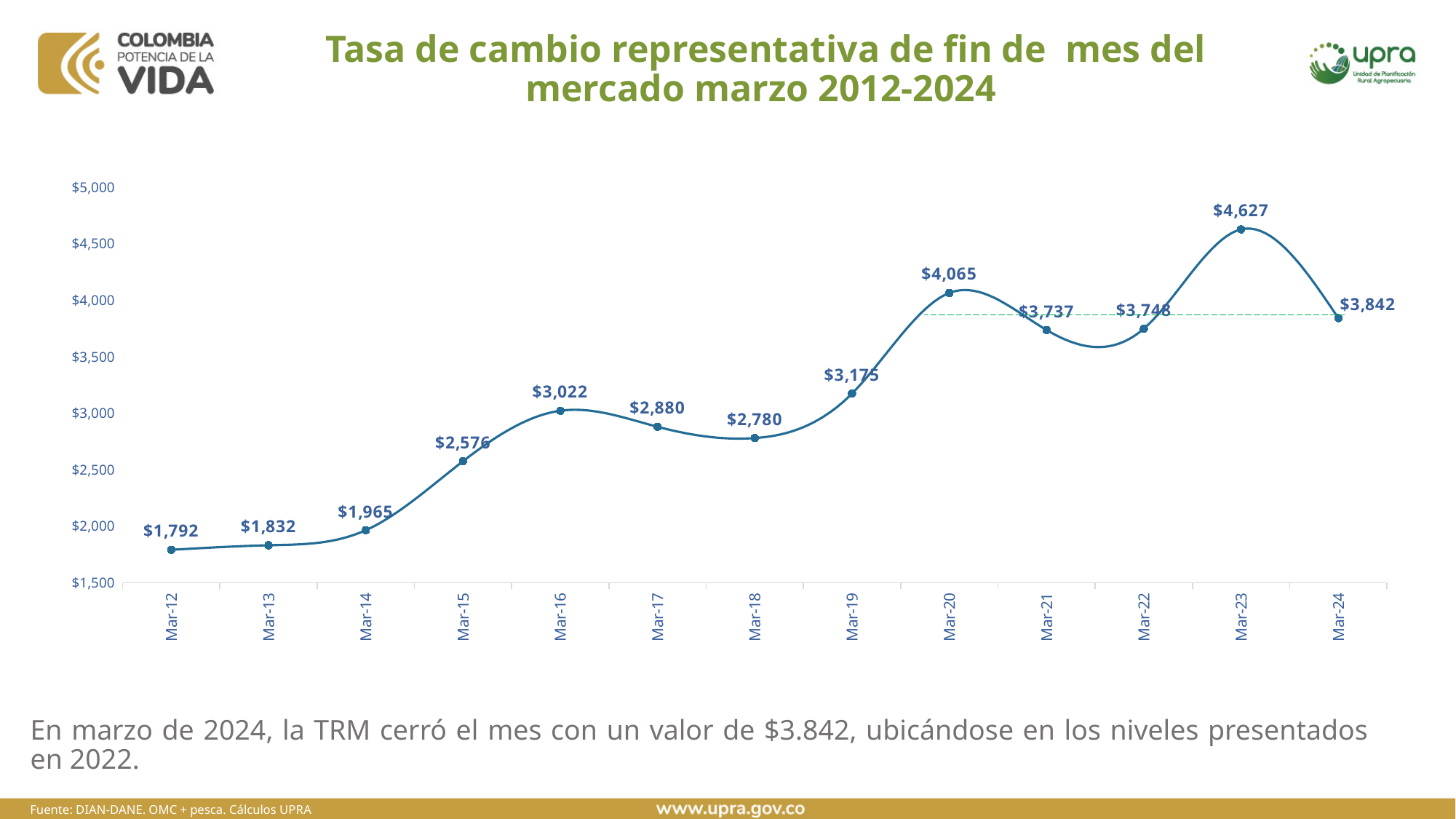
Is the value for Mar-15 greater or less than $2,500? greater Which point has the lowest value? Mar-12 Which is larger, the value for Mar-17 or the value for Mar-18? Mar-17 Do the values rise or fall from Mar-12 to Mar-16? rise What is the value for Mar-12? $1,792 What is the value for Mar-16? $3,022 How many data points are plotted on the chart? 13 Which point has the highest value? Mar-23 What is the difference between the values for Mar-23 and Mar-24? $785 What kind of chart is shown on the slide? line chart What is the value for Mar-24? $3,842 What is the difference between the values for Mar-20 and Mar-19? $890